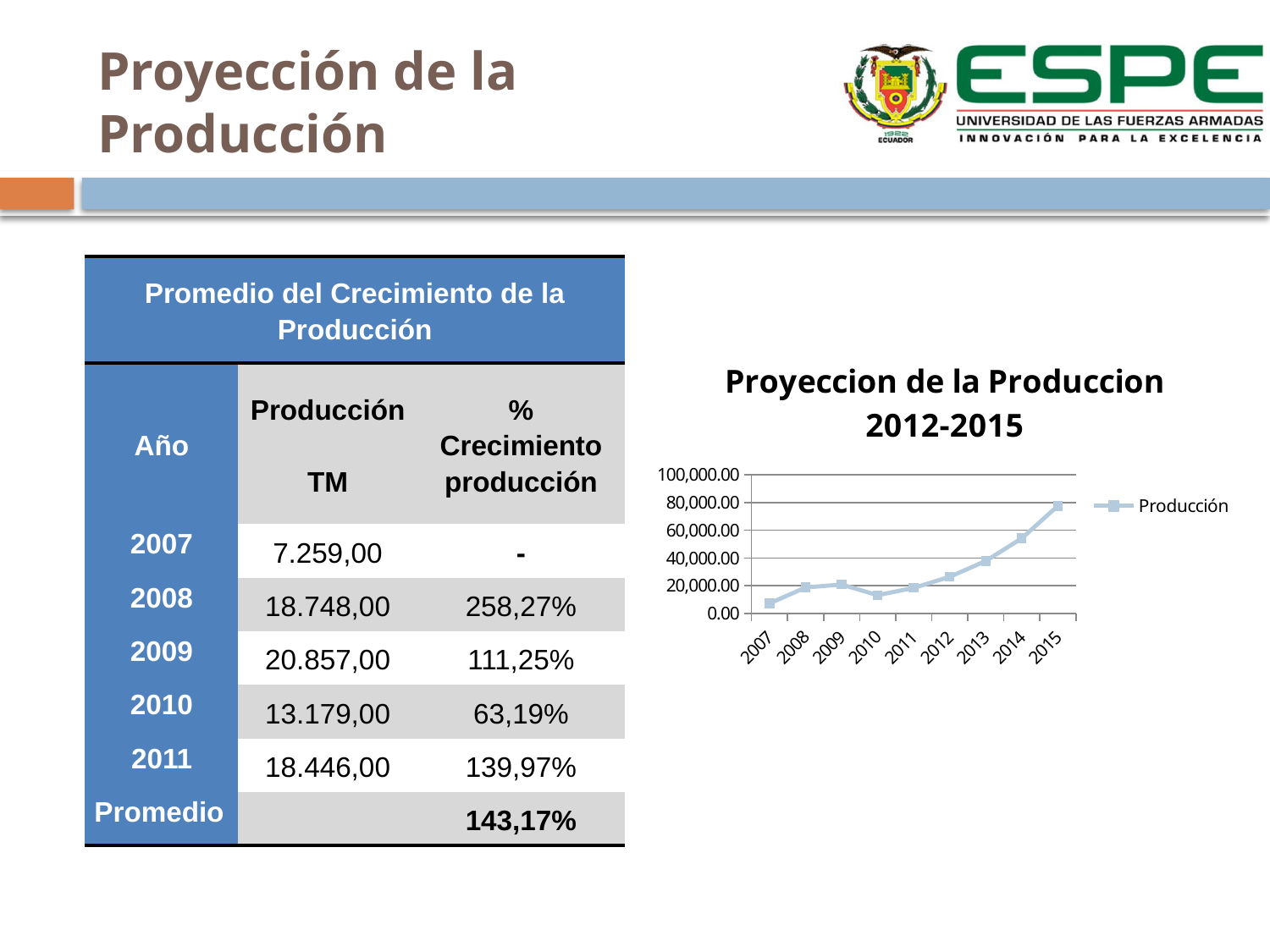
How many series does the chart legend list? 1 What kind of chart is shown on the slide? line chart Which year has the larger Producción value, 2009 or 2010? 2009 Which year has the highest Producción value in the chart? 2015 Is the Producción value for 2007 greater or less than 20,000.00? less Is the Producción value for 2015 greater or less than 60,000.00? greater How many years are plotted along the x axis of the chart? 9 Is the Producción value for 2014 greater or less than 40,000.00? greater What is the title of the chart? Proyeccion de la Produccion 2012-2015 What is the name of the series shown in the chart legend? Producción Does the Producción line generally rise or fall from 2011 to 2015? rise Which year has the lowest Producción value in the chart? 2007